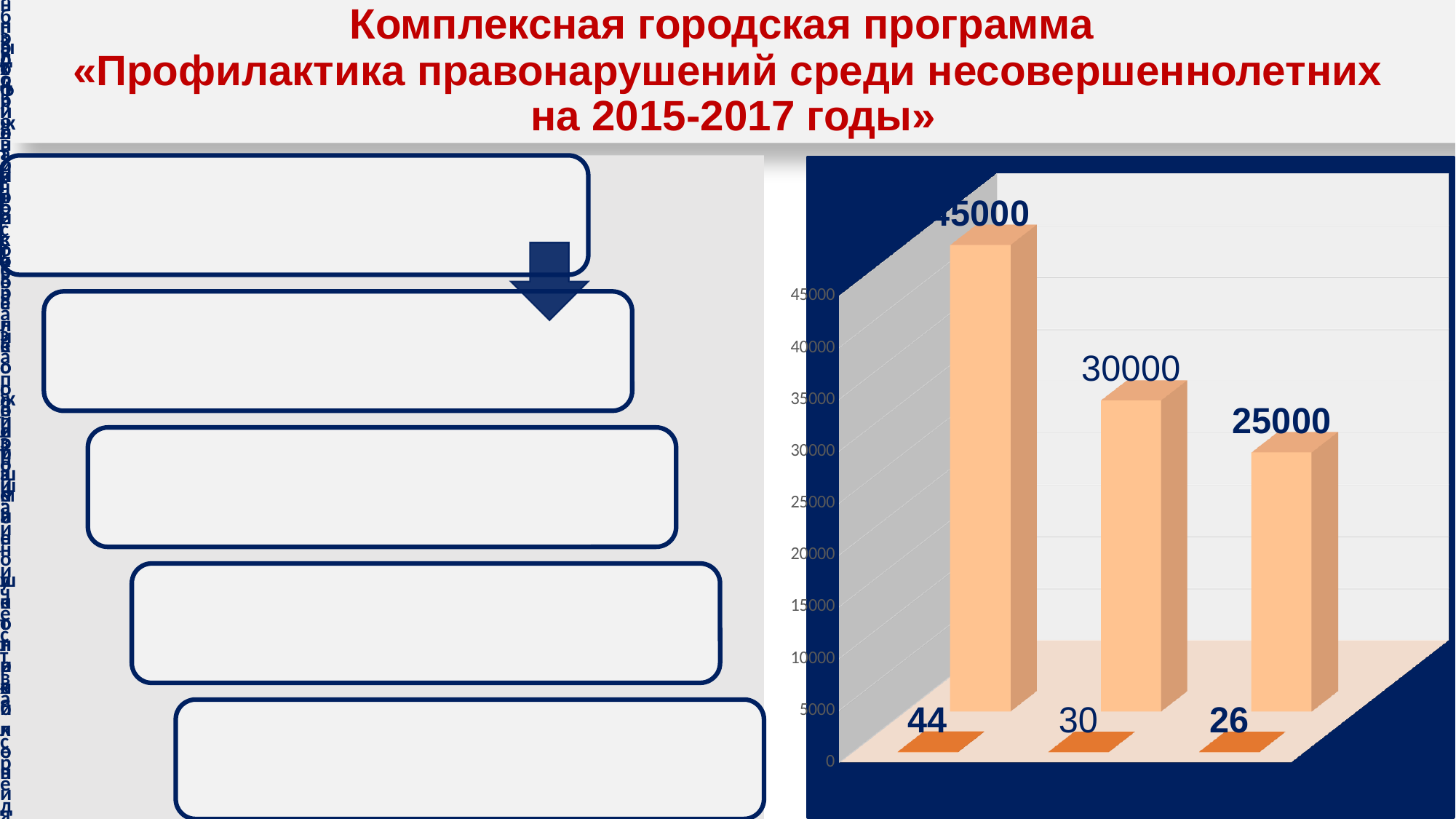
Which tall bar has the lowest value: the left, middle or right one? right What is the difference between the middle tall bar's value and the rightmost tall bar's value? 5000 What is the small value printed at the base of the middle bar? 30 What is the data label on the leftmost tall bar of the chart? 45000 What is the data label on the rightmost tall bar of the chart? 25000 What kind of chart is shown on the right side of the slide? bar chart Do the tall bar values rise or fall from left to right? fall What is the data label on the middle tall bar of the chart? 30000 What is the small value printed at the base of the rightmost bar? 26 Which tall bar has the highest value: the left, middle or right one? left How many tall bars (categories) are plotted in the chart? 3 What is the small value printed at the base of the leftmost bar? 44